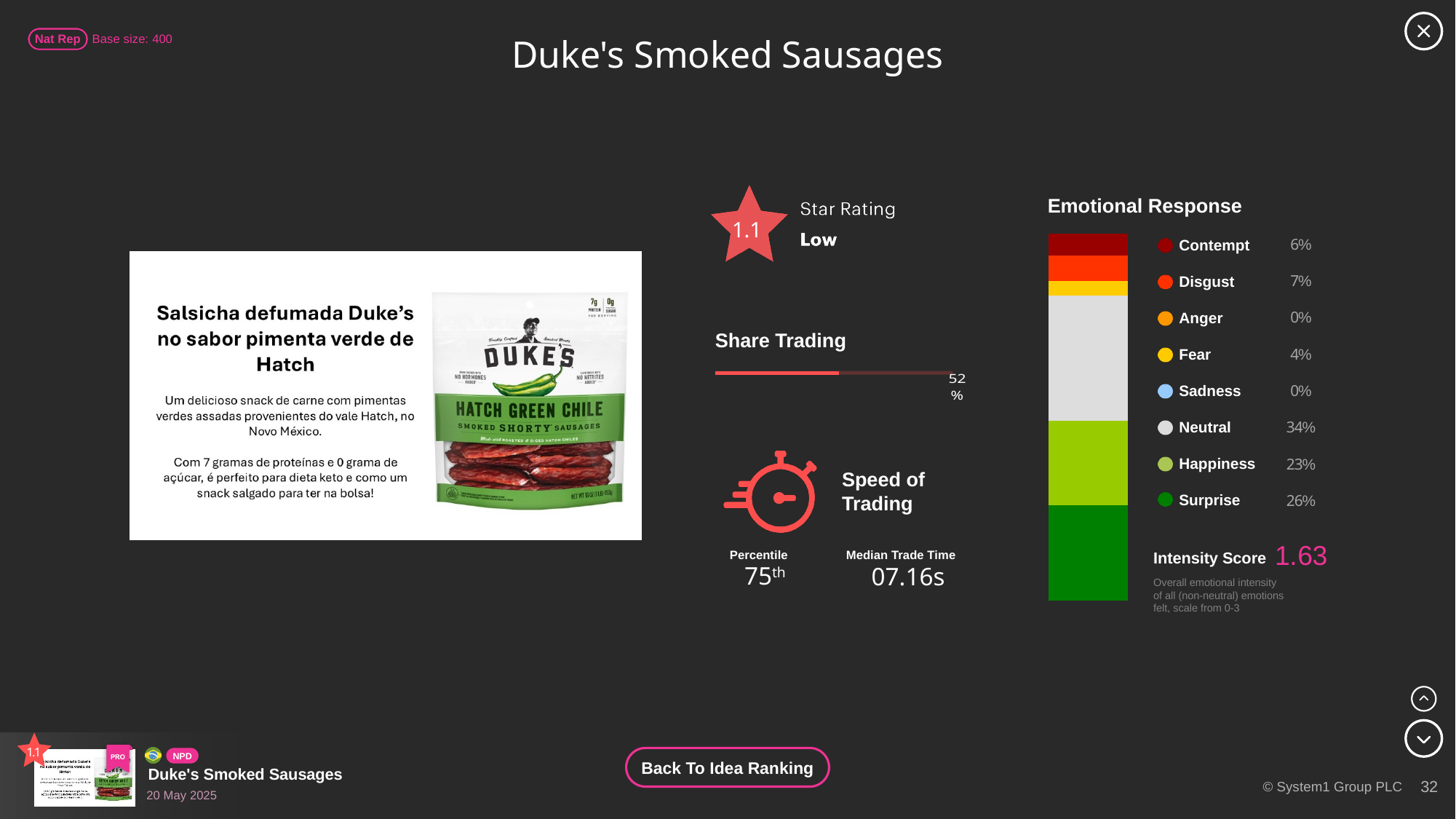
What kind of chart is the Emotional Response chart? Stacked bar chart In the Emotional Response chart, which is larger, Disgust or Contempt? Disgust In the Emotional Response chart, what percentage is shown for Happiness? 23% In the Emotional Response chart, what is the difference between the Surprise and Happiness percentages? 3% How many emotions are listed in the Emotional Response chart legend? 8 What value is shown on the Share Trading bar? 52% In the Emotional Response chart, which two emotions are shown at 0%? Anger and Sadness In the Emotional Response chart, what percentage is shown for Surprise? 26% In the Emotional Response chart, what is the difference between the Neutral and Surprise percentages? 8% In the Emotional Response chart, which emotion has the highest percentage? Neutral In the Emotional Response chart, what percentage is shown for Neutral? 34% In the Emotional Response chart, what percentage is shown for Fear? 4%